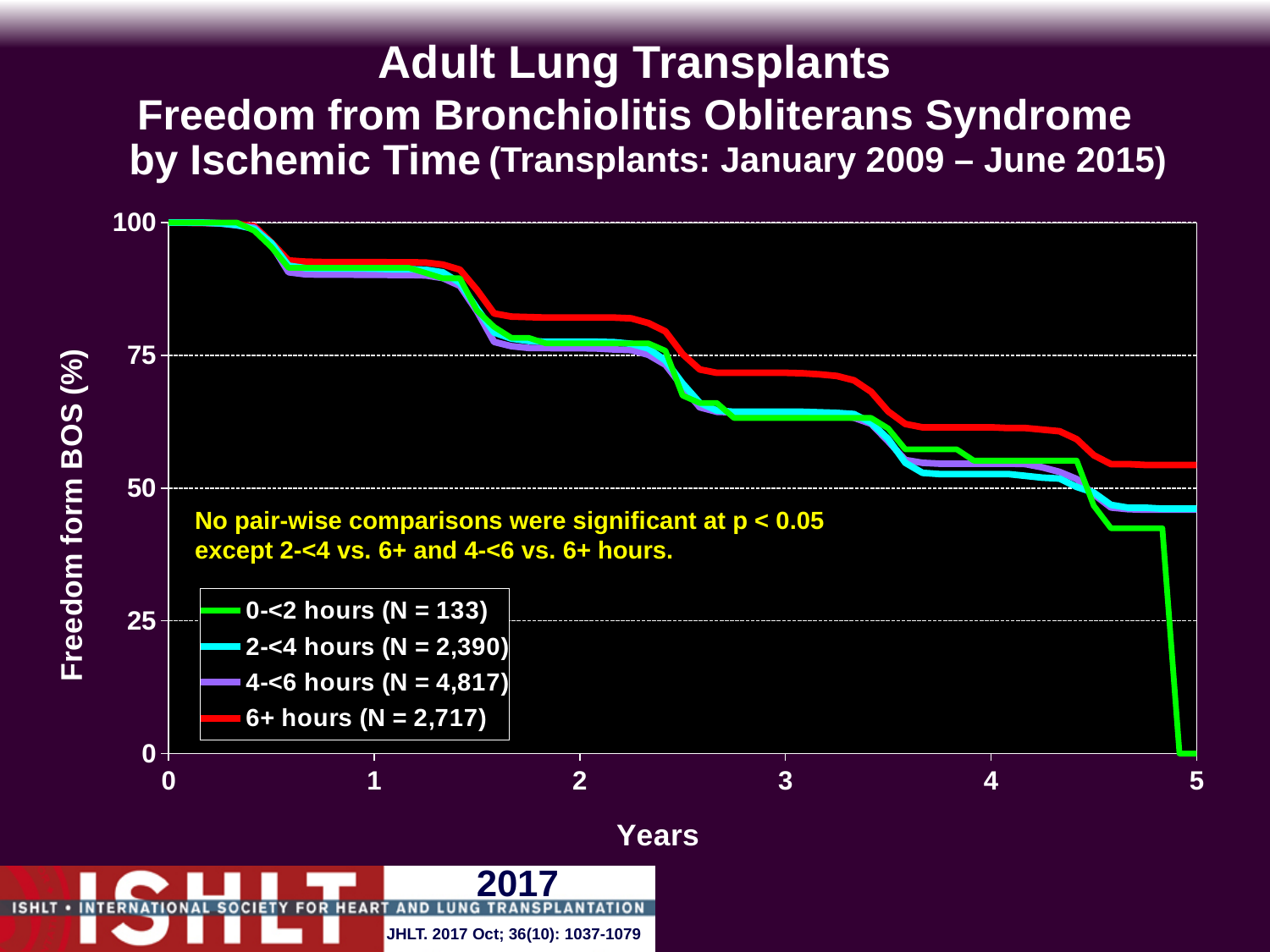
What kind of chart is shown on the slide? line chart What is the freedom from BOS value for the 6+ hours group at year 0? 100 At year 3, is the freedom from BOS for the 0-<2 hours group greater or less than 50? greater What is the N for the 2-<4 hours group shown in the legend? 2,390 At year 3, which group has the higher freedom from BOS: 6+ hours or 0-<2 hours? 6+ hours Do the freedom from BOS values rise or fall as years increase? fall At year 2, is the freedom from BOS for the 6+ hours group greater or less than 75? greater How many series does the legend list? 4 Which ischemic time group has the highest freedom from BOS at year 4? 6+ hours At year 3, is the freedom from BOS for the 6+ hours group greater or less than 75? less What is the N for the 6+ hours group shown in the legend? 2,717 Which ischemic time group has the lowest freedom from BOS at year 5? 0-<2 hours